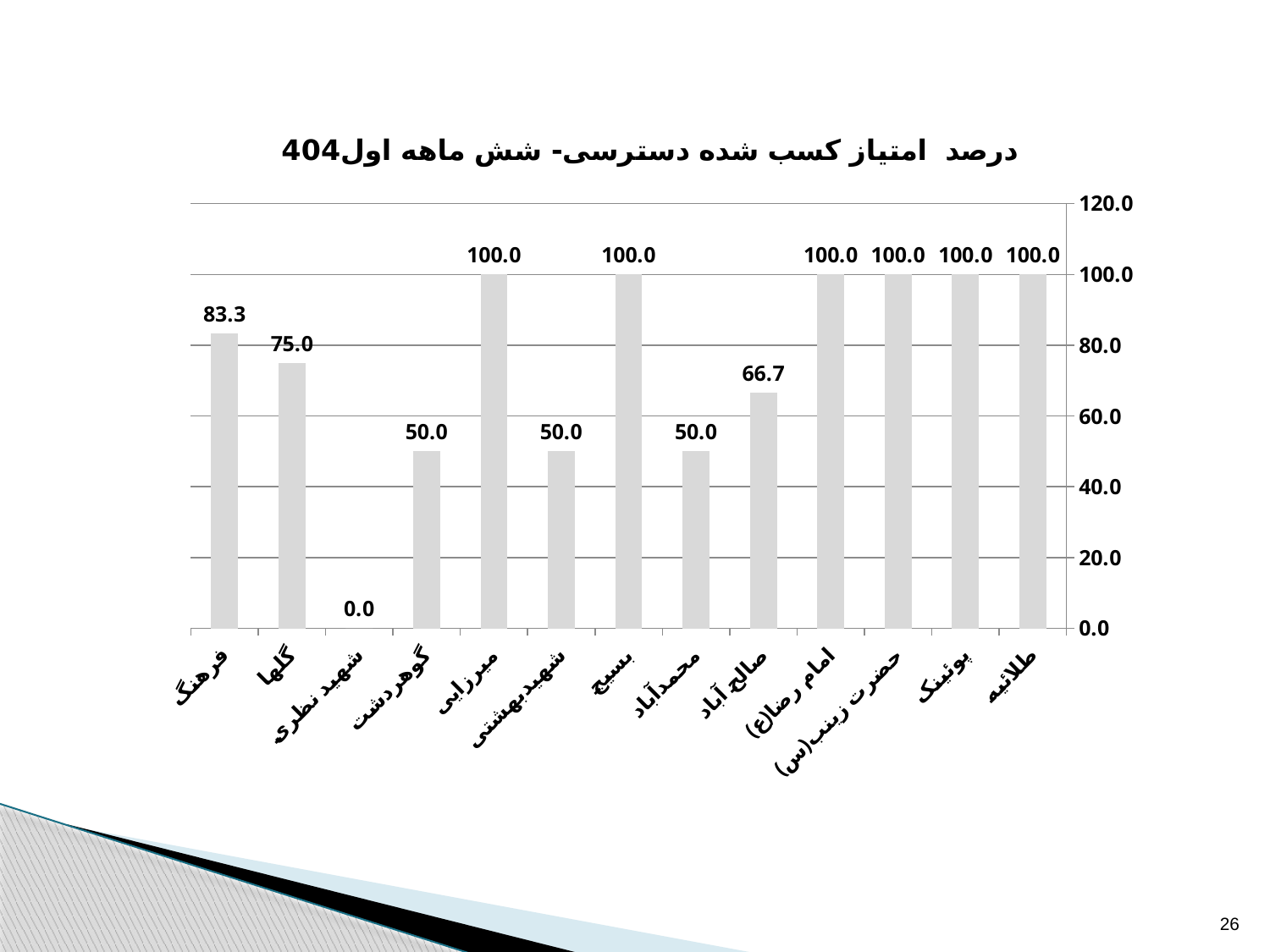
What is the value for فرهنگ? 83.3 What is the difference between the values for صالح آباد and محمدآباد? 16.7 Is the value for فرهنگ greater or less than 80.0? greater Which is larger, the value for گلها or the value for صالح آباد? گلها Which category has the lowest value? شهید نظری What is the difference between the values for فرهنگ and گلها? 8.3 What is the value for گلها? 75.0 How many categories are shown on the x axis? 13 What kind of chart is shown on the slide? bar chart What is the value for صالح آباد? 66.7 What is the title of the chart? درصد امتیاز کسب شده دسترسی- شش ماهه اول404 What is the value for گوهردشت? 50.0